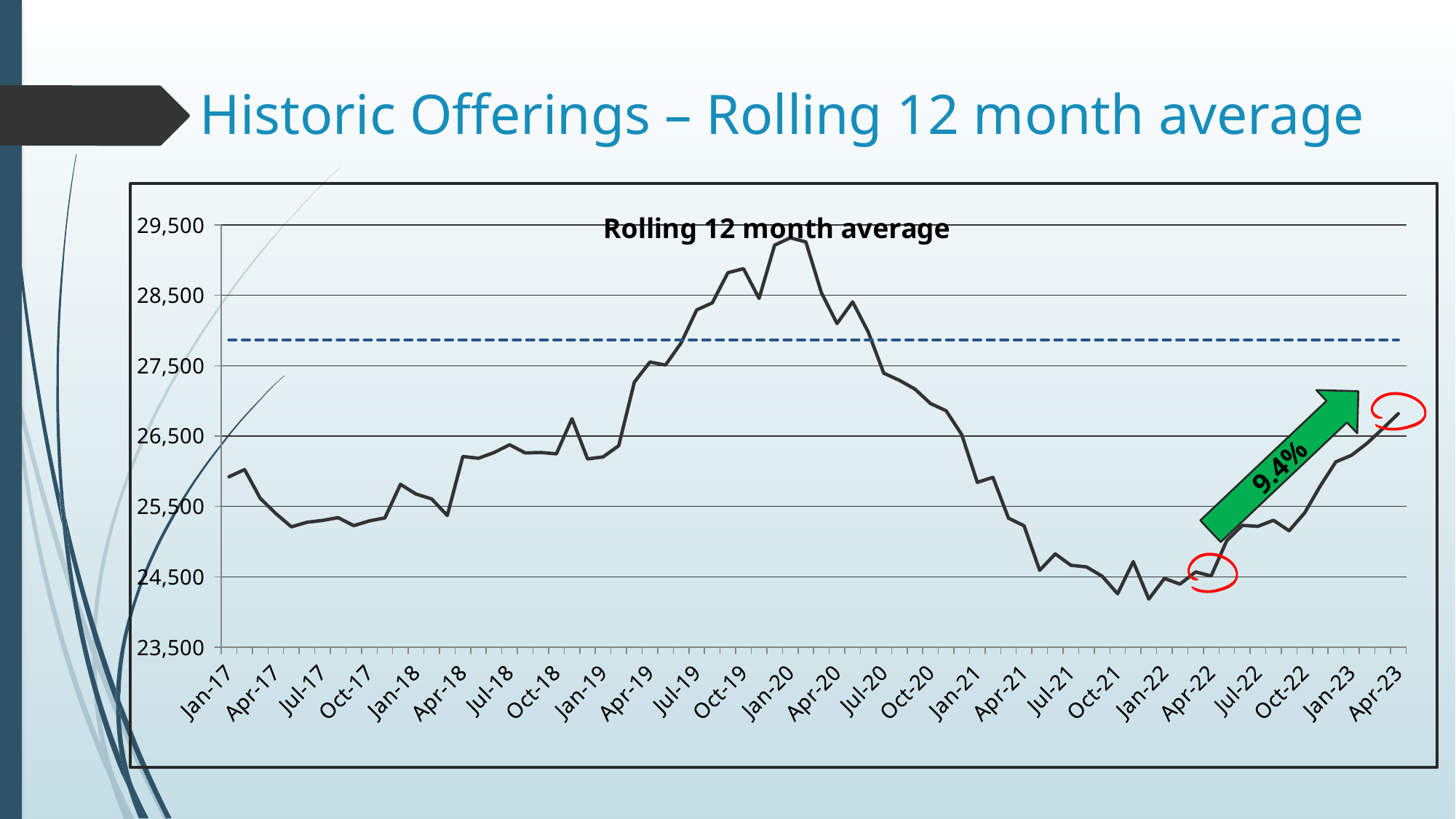
Is the value for Jul-21 greater or less than 25,500? less What kind of chart is shown on the slide? line chart Which is larger, the value for Apr-22 or the value for Apr-23? Apr-23 Is the value for Jan-20 greater or less than 28,500? greater Is the value for Apr-22 greater or less than 25,500? less What is the title printed inside the chart area? Rolling 12 month average What percentage is printed on the green arrow in the chart? 9.4% Which is larger, the value for Jan-17 or the value for Jan-20? Jan-20 Does the line rise or fall between Jan-20 and Jan-22? fall Does the line rise or fall between Apr-22 and Apr-23? rise